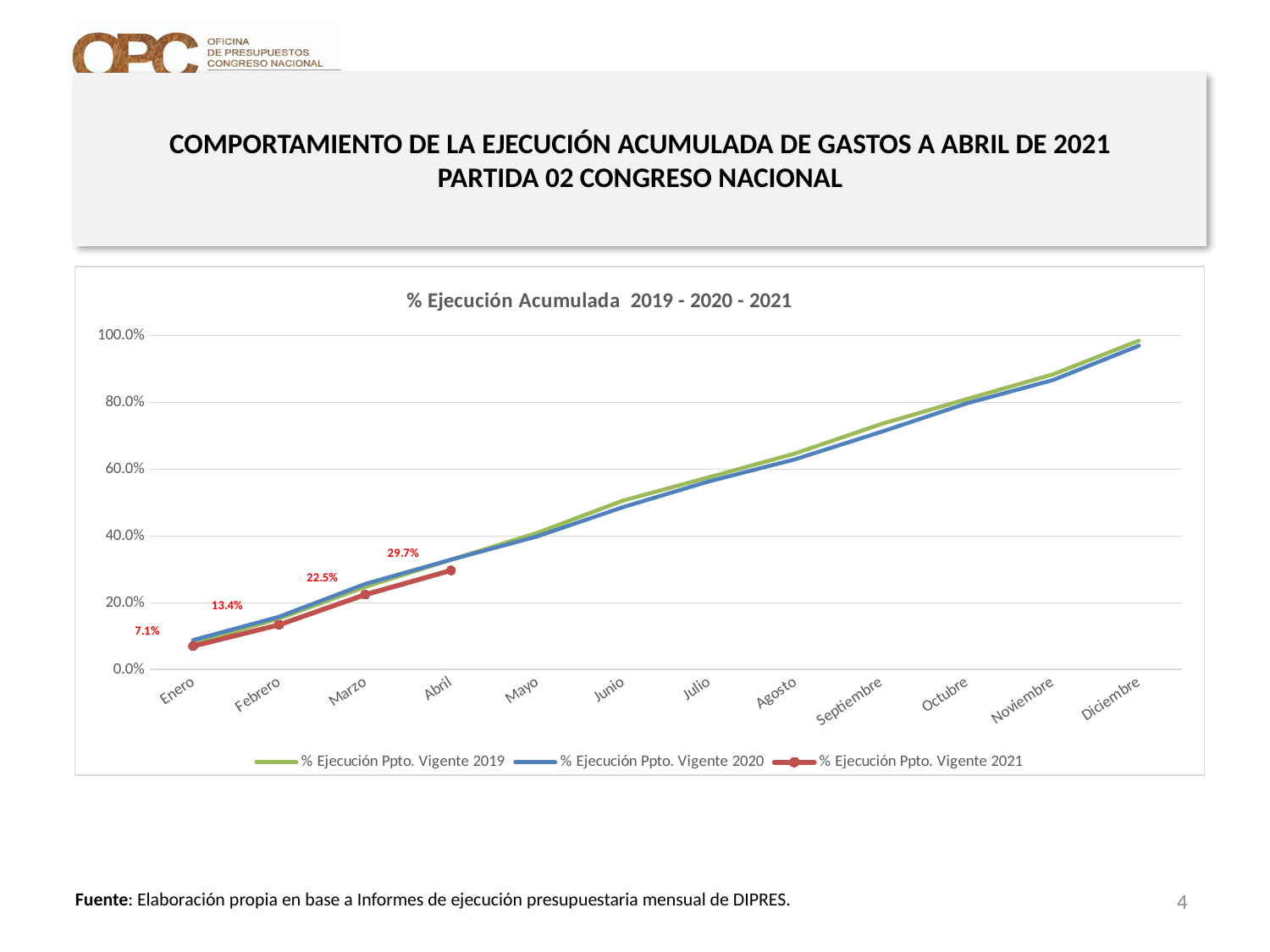
What is the title of the chart? % Ejecución Acumulada 2019 - 2020 - 2021 How many months are shown on the x axis? 12 What kind of chart is shown on the slide? Line chart Do the values of the % Ejecución Ppto. Vigente 2020 series rise or fall from Enero to Diciembre? Rise What is the value for Marzo in the % Ejecución Ppto. Vigente 2021 series? 22.5% Which month has the highest value in the % Ejecución Ppto. Vigente 2021 series? Abril Is the value for Diciembre in the % Ejecución Ppto. Vigente 2020 series greater or less than 80.0%? greater What is the value for Abril in the % Ejecución Ppto. Vigente 2021 series? 29.7% What is the value for Enero in the % Ejecución Ppto. Vigente 2021 series? 7.1% What is the value for Febrero in the % Ejecución Ppto. Vigente 2021 series? 13.4% How many series does the legend list? 3 What is the difference between the Abril and Marzo values in the % Ejecución Ppto. Vigente 2021 series? 7.2%